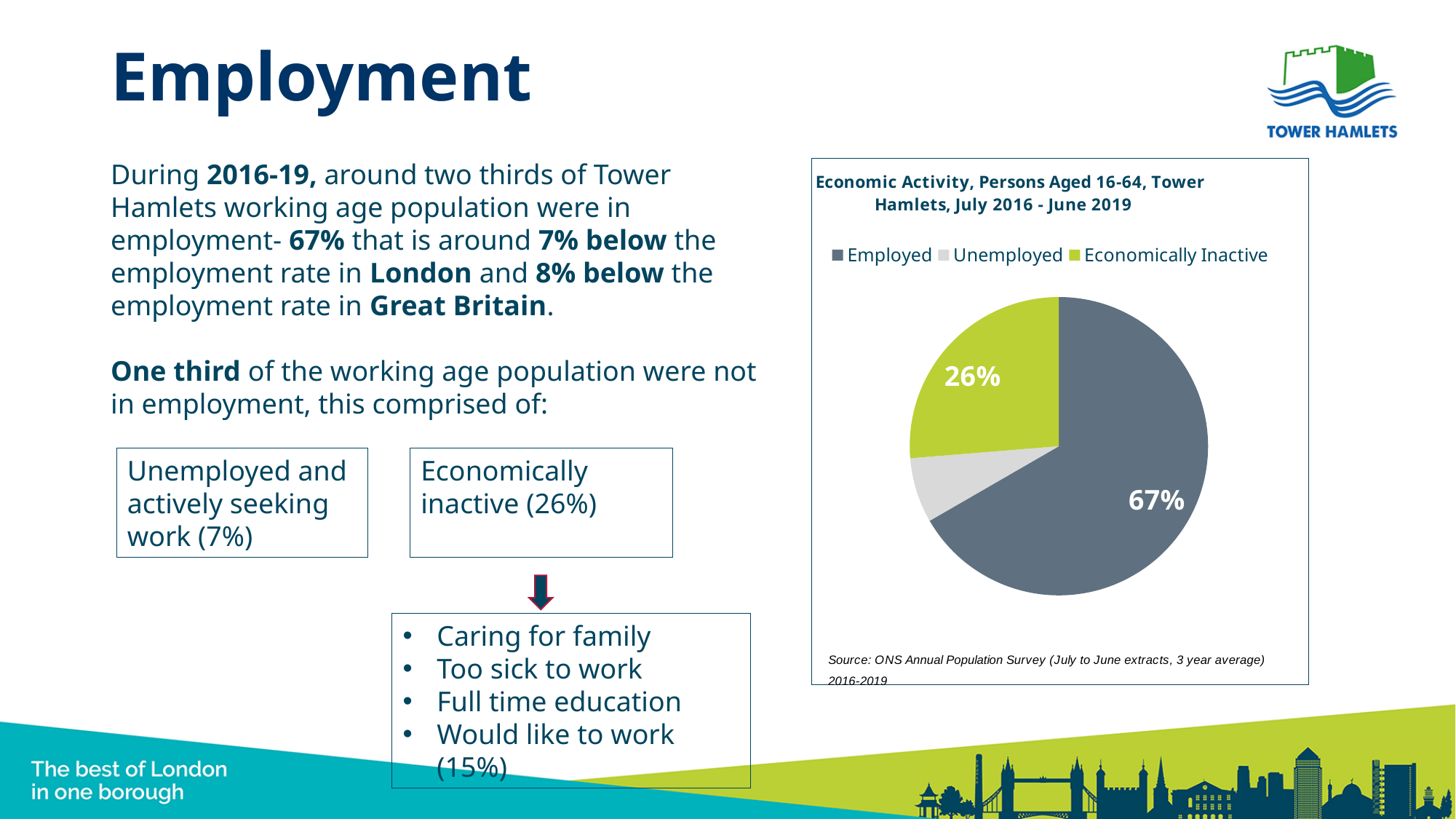
Which slice is larger, Employed or Economically Inactive? Employed What colour is the Economically Inactive slice in the pie chart? Green What percentage is shown for the Economically Inactive slice? 26% Which category has the largest slice of the pie chart? Employed How many categories are shown in the pie chart? 3 What is the title of the chart? Economic Activity, Persons Aged 16-64, Tower Hamlets, July 2016 - June 2019 What is the difference in percentage points between the Employed and Economically Inactive slices? 41 percentage points What share of the pie does the Employed slice represent? 67% What percentage of the pie chart is labelled for the Employed slice? 67% How many entries does the chart legend list? 3 Which category has the smallest slice of the pie chart? Unemployed What type of chart is shown on the slide? Pie chart